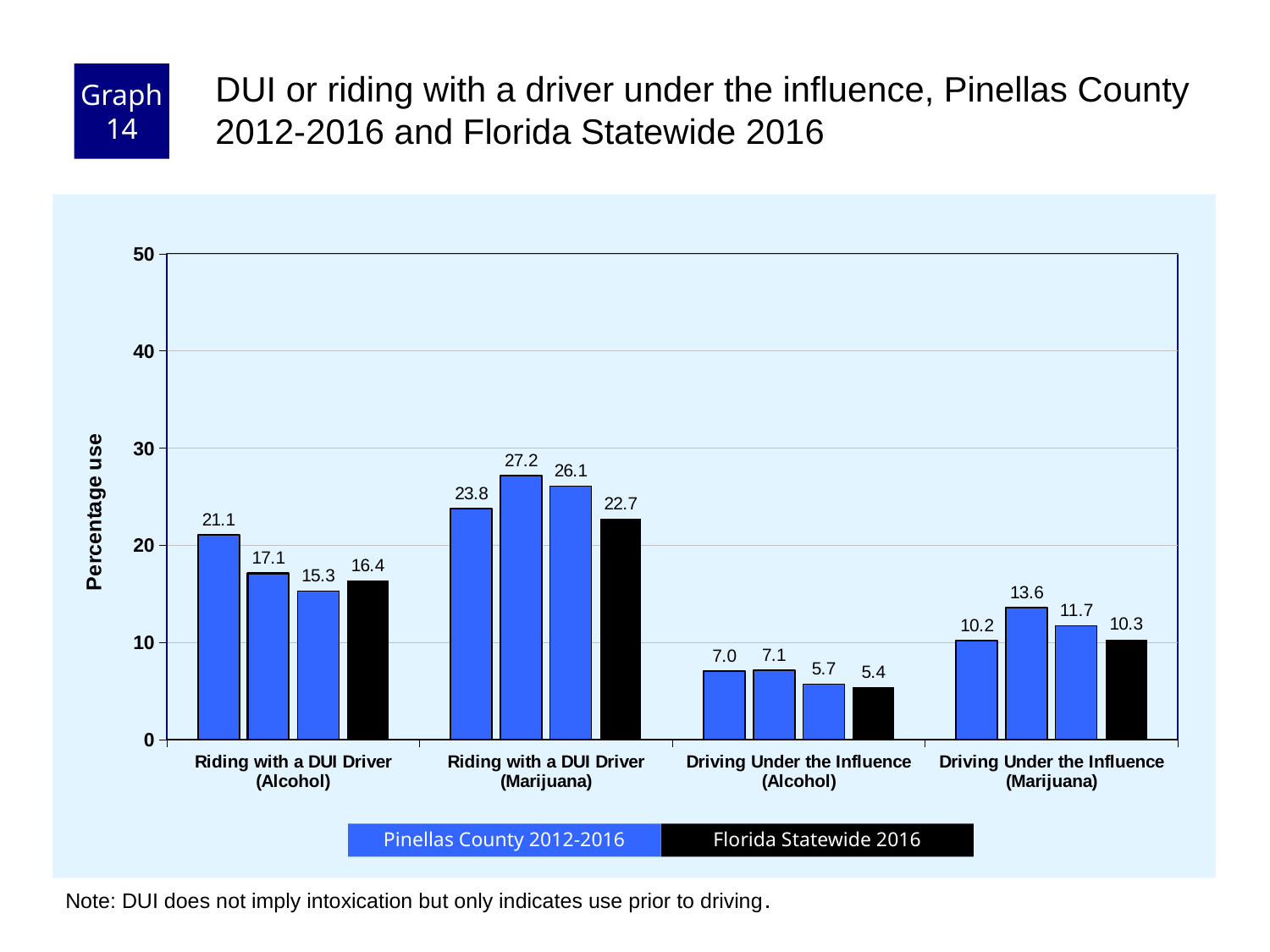
What is the Florida Statewide 2016 value for Riding with a DUI Driver (Alcohol)? 16.4 What is the Florida Statewide 2016 value for Riding with a DUI Driver (Marijuana)? 22.7 What is the Florida Statewide 2016 value for Driving Under the Influence (Alcohol)? 5.4 How many series does the legend list? 2 What is the difference between the Florida Statewide 2016 values for Riding with a DUI Driver (Marijuana) and Riding with a DUI Driver (Alcohol)? 6.3 What is the lowest value shown on the chart? 5.4 What is the highest value shown on the chart? 27.2 Is the Florida Statewide 2016 value for Driving Under the Influence (Marijuana) larger or smaller than the Florida Statewide 2016 value for Driving Under the Influence (Alcohol)? larger How many categories are shown on the x axis? 4 What is the Florida Statewide 2016 value for Driving Under the Influence (Marijuana)? 10.3 What type of chart is shown on the slide? bar chart Which category has the highest Florida Statewide 2016 value? Riding with a DUI Driver (Marijuana)